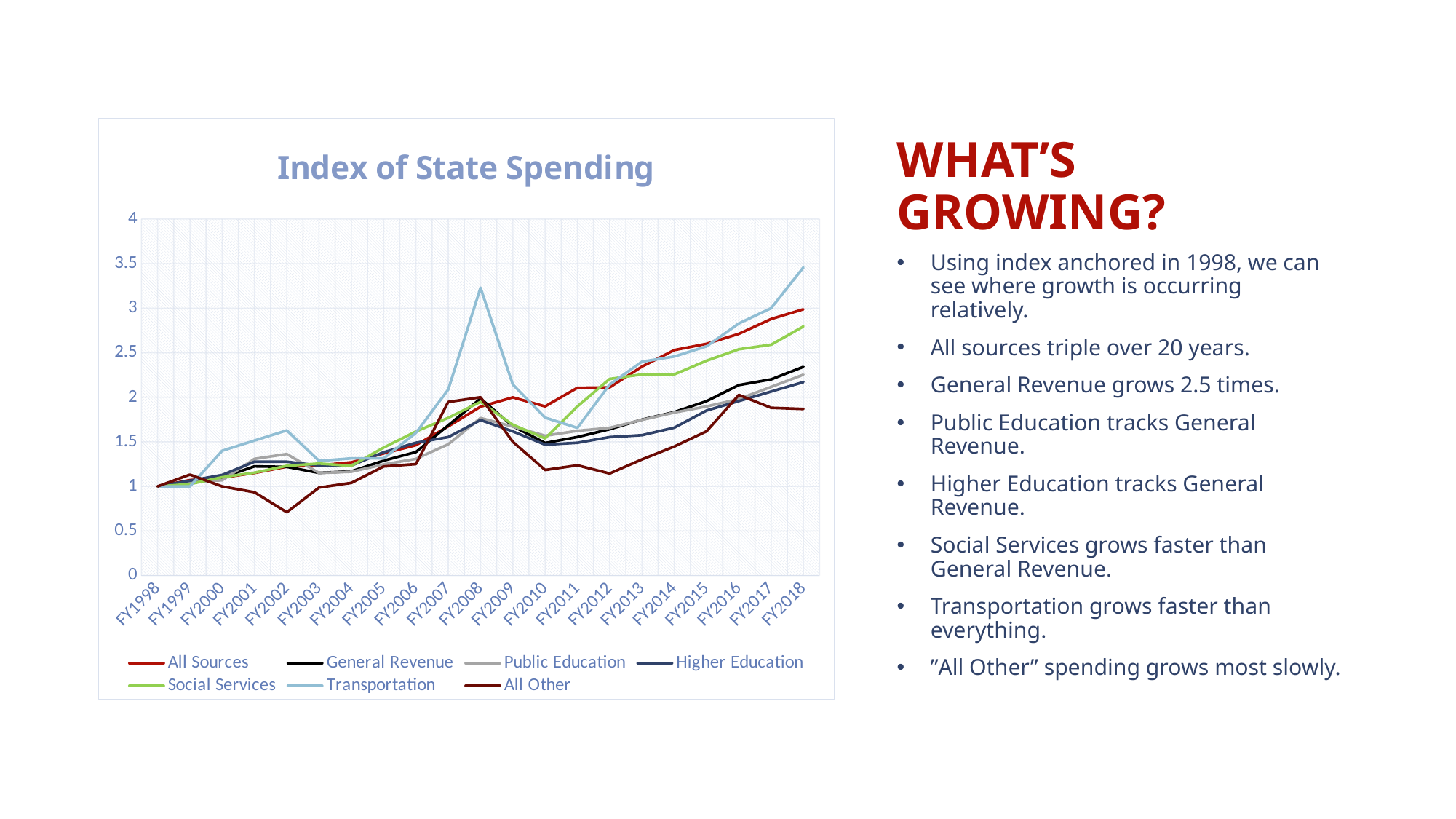
Does the Transportation series generally rise or fall from FY1998 to FY2018? rise Is the value for All Other in FY2002 greater or less than 1? less In FY2018, which is larger: the value for All Sources or the value for General Revenue? All Sources What is the title of the chart? Index of State Spending What kind of chart is shown on the slide? line chart How many series does the chart's legend list? 7 How many fiscal years are shown along the x axis of the chart? 21 Which series has the highest value in FY2018? Transportation Which series has the lowest value in FY2002? All Other Which series has the lowest value in FY2018? All Other What is the value of the All Sources series in FY1998? 1 Is the value for Transportation in FY2018 greater or less than 3? greater